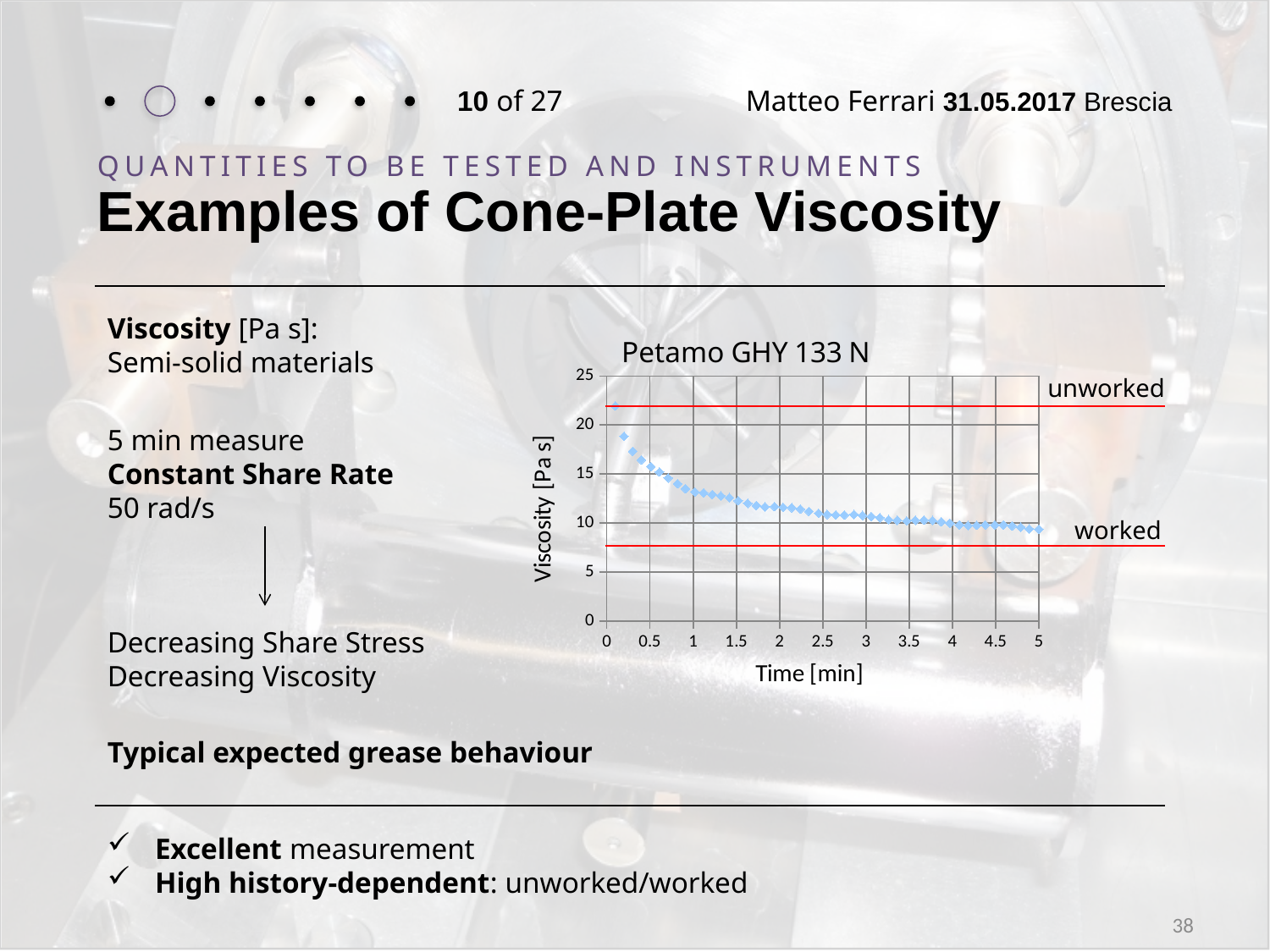
What is the title of the chart? Petamo GHY 133 N Is the viscosity value at 1 min greater or less than 15? less What is the maximum value shown on the y axis of the chart? 25 Does the viscosity rise or fall as time increases along the x axis? fall Is the viscosity value at 2 min greater or less than 10? greater What is the label of the x axis of the chart? Time [min] What kind of chart is shown on the slide? scatter chart Is the viscosity value at 5 min greater or less than 5? greater Which of the two red horizontal reference lines is higher, the one labelled 'unworked' or the one labelled 'worked'? unworked